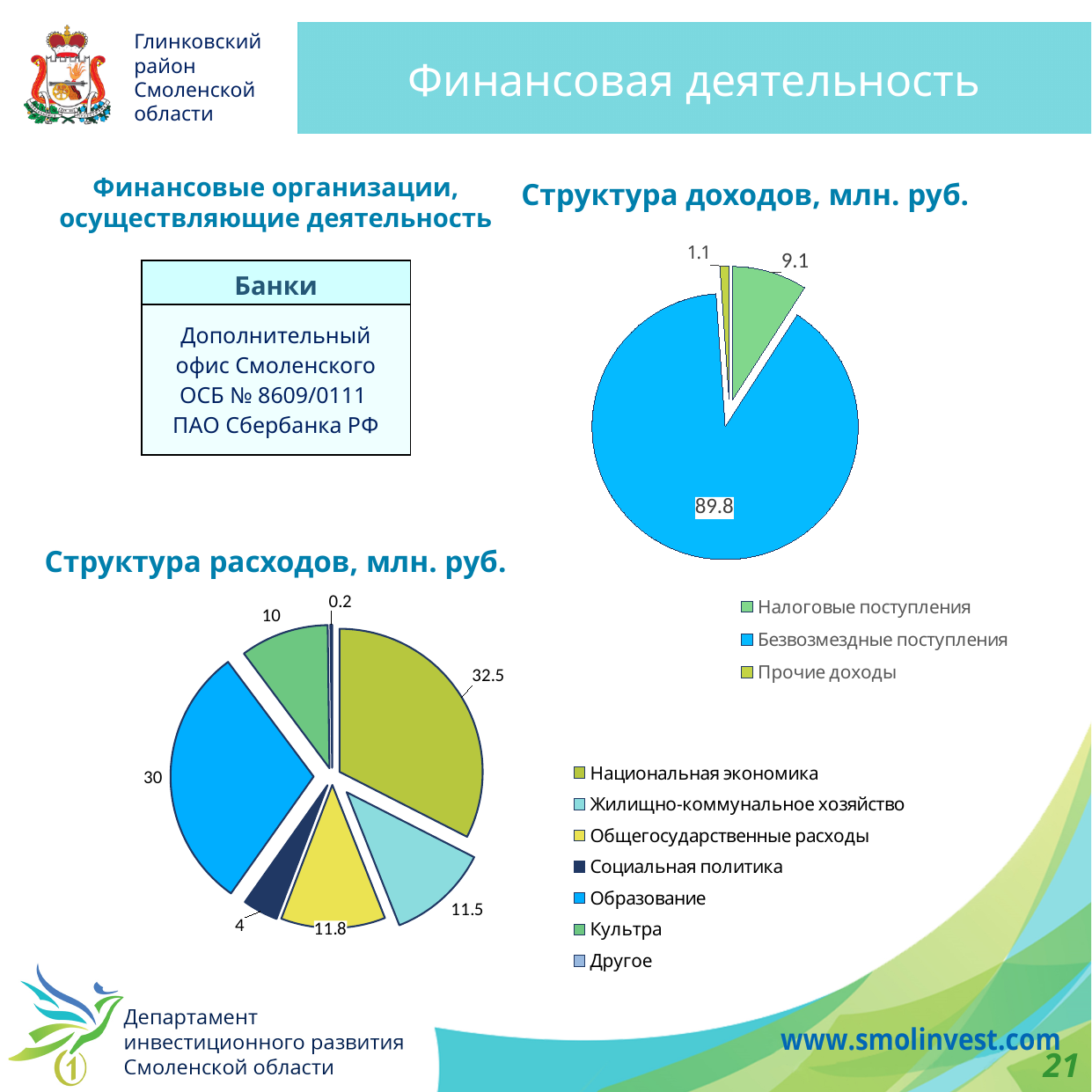
In the chart 'Структура доходов, млн. руб.', how many categories does the legend list? 3 In the chart 'Структура доходов, млн. руб.', what is the value for Безвозмездные поступления? 89.8 In the chart 'Структура расходов, млн. руб.', which category has the largest value? Национальная экономика In the chart 'Структура расходов, млн. руб.', which category has the smallest value? Другое In the chart 'Структура расходов, млн. руб.', what is the value for Общегосударственные расходы? 11.8 In the chart 'Структура расходов, млн. руб.', what is the value for Образование? 30 What type of chart is used for 'Структура расходов, млн. руб.'? Pie chart In the chart 'Структура расходов, млн. руб.', how many categories does the legend list? 7 In the chart 'Структура расходов, млн. руб.', which is larger: Культура or Социальная политика? Культура In the chart 'Структура доходов, млн. руб.', what is the value for Налоговые поступления? 9.1 In the chart 'Структура доходов, млн. руб.', which category has the smallest value? Прочие доходы In the chart 'Структура доходов, млн. руб.', what is the difference between Безвозмездные поступления and Налоговые поступления? 80.7